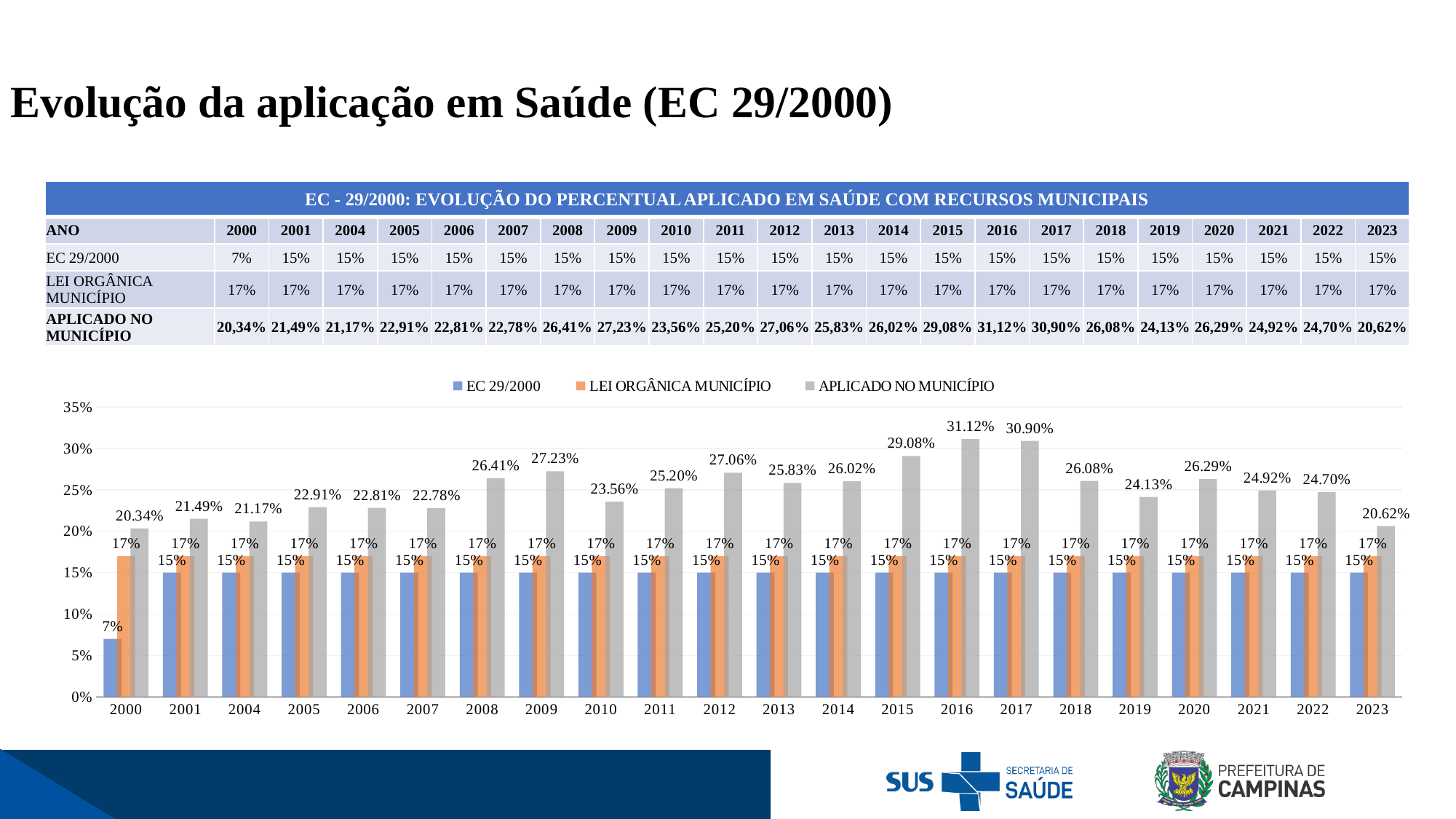
What is the value of APLICADO NO MUNICÍPIO for 2016? 31.12% How many years are shown on the x axis of the chart? 22 In which year is APLICADO NO MUNICÍPIO lowest? 2000 What is the value of EC 29/2000 for 2000? 7% What colour are the bars for the LEI ORGÂNICA MUNICÍPIO series? Orange Which is larger, APLICADO NO MUNICÍPIO in 2009 or in 2010? 2009 Does APLICADO NO MUNICÍPIO rise or fall from 2017 to 2019? Fall What type of chart is shown on the slide? Bar chart How many series does the chart legend list? 3 What is the difference between APLICADO NO MUNICÍPIO in 2016 and in 2017? 0.22% What is the value of APLICADO NO MUNICÍPIO for 2023? 20.62% In which year is APLICADO NO MUNICÍPIO highest? 2016